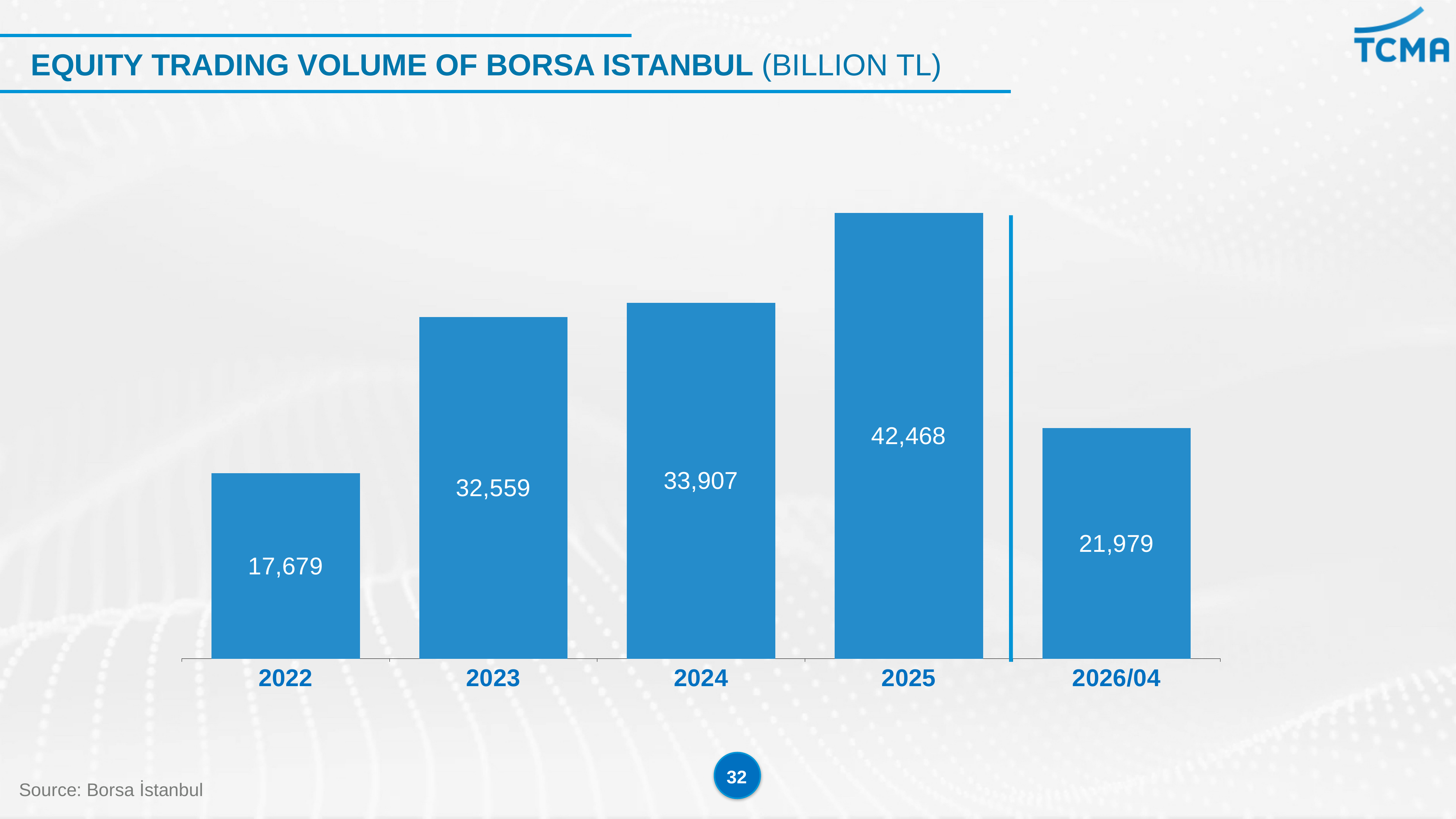
How many categories are shown on the x axis? 5 What is the equity trading volume for 2025? 42,468 What is the equity trading volume for 2022? 17,679 What kind of chart is shown on the slide? bar chart What is the difference between the equity trading volume in 2023 and 2022? 14,880 In what unit is the equity trading volume expressed, according to the chart title? Billion TL Which year has the highest equity trading volume? 2025 Which category has the lowest equity trading volume? 2022 Which is larger, the equity trading volume in 2024 or in 2023? 2024 What is the difference between the equity trading volume in 2025 and 2024? 8,561 Do the values rise or fall from 2022 to 2025? rise What is the equity trading volume for 2026/04? 21,979